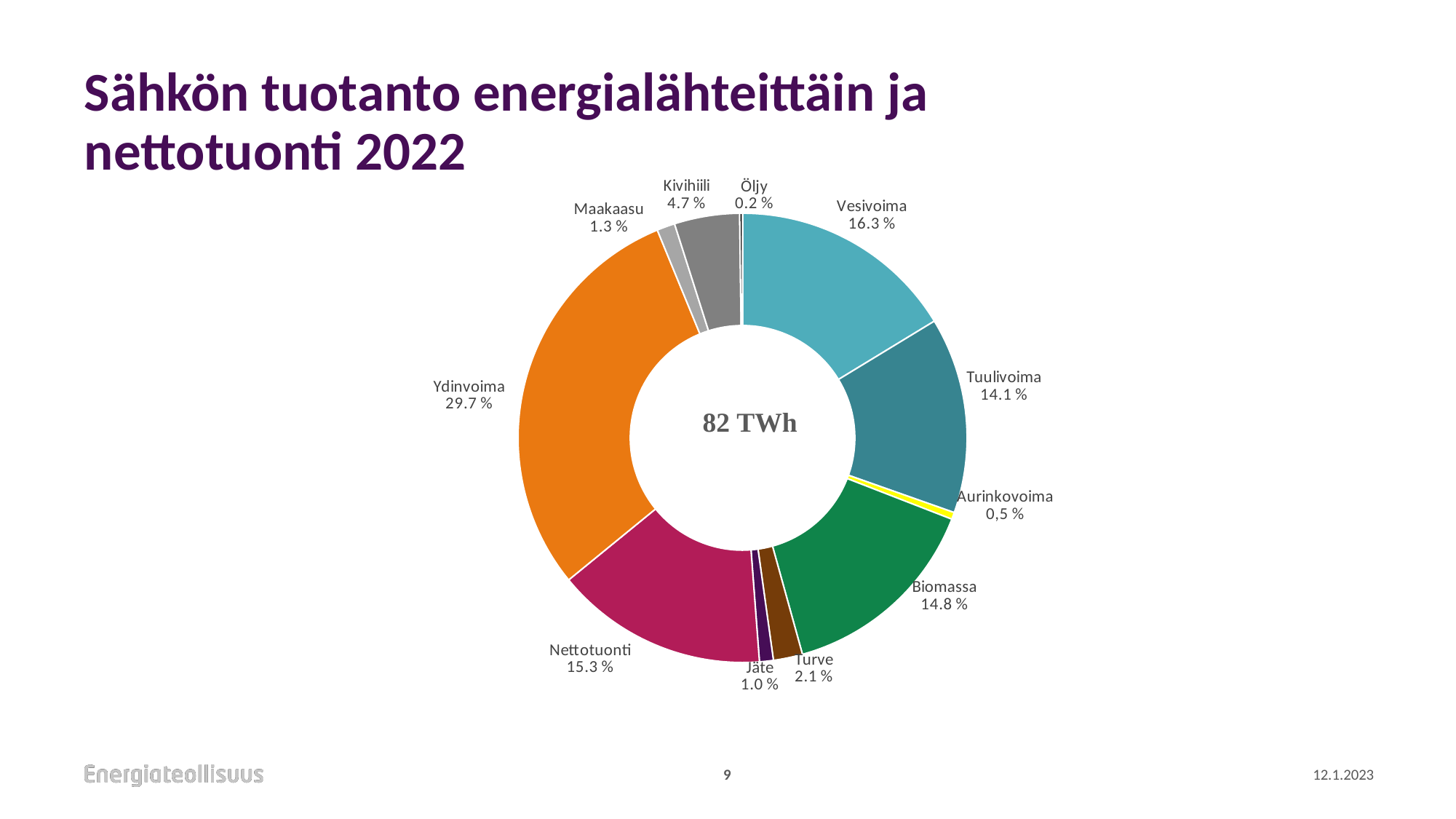
Which category has the smallest share in the chart? Öljy What is the difference in percentage points between Ydinvoima and Vesivoima? 13.4 % How many categories are shown in the chart? 11 What share does Vesivoima have in the chart? 16.3 % What is the difference in percentage points between Biomassa and Tuulivoima? 0.7 % Which has a larger share, Kivihiili or Turve? Kivihiili Which has a larger share, Vesivoima or Tuulivoima? Vesivoima What share does Aurinkovoima have in the chart? 0,5 % What total value is shown in the centre of the chart? 82 TWh Which category has the largest share in the chart? Ydinvoima What share does Nettotuonti have in the chart? 15.3 % What share does Ydinvoima have in the chart? 29.7 %